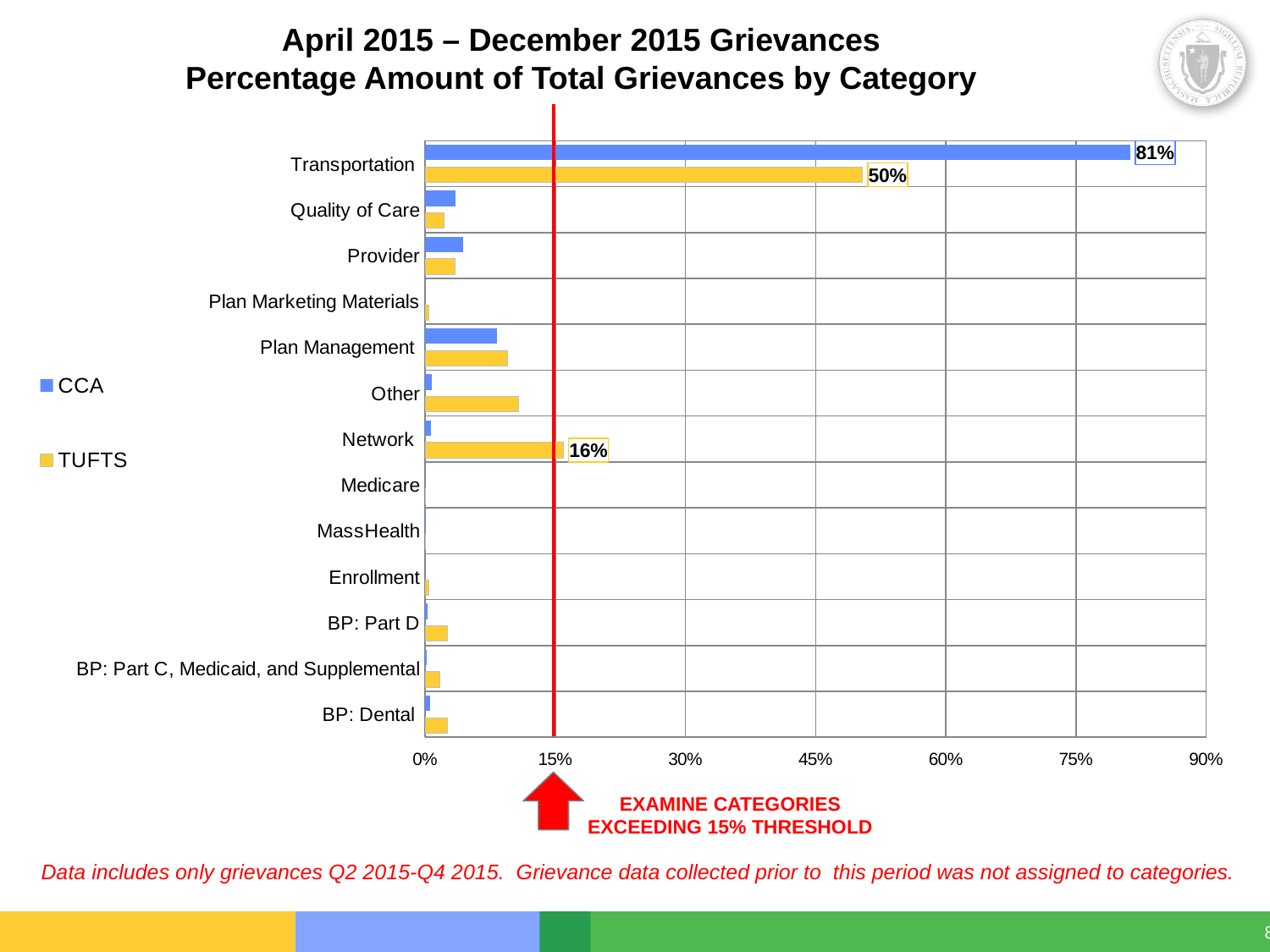
How many series does the legend list? 2 For the Other category, which series has the larger value, CCA or TUFTS? TUFTS What is the difference between the TUFTS values for Transportation and Network? 34% Is the TUFTS value for Plan Management greater or less than 15%? less What is the TUFTS value for Transportation? 50% What is the CCA value for Transportation? 81% What is the TUFTS value for Network? 16% What kind of chart is shown on the slide? bar chart What is the difference between the CCA and TUFTS values for Transportation? 31% For Transportation, which series has the larger value, CCA or TUFTS? CCA Which category has the highest CCA value? Transportation How many categories are shown on the chart? 13